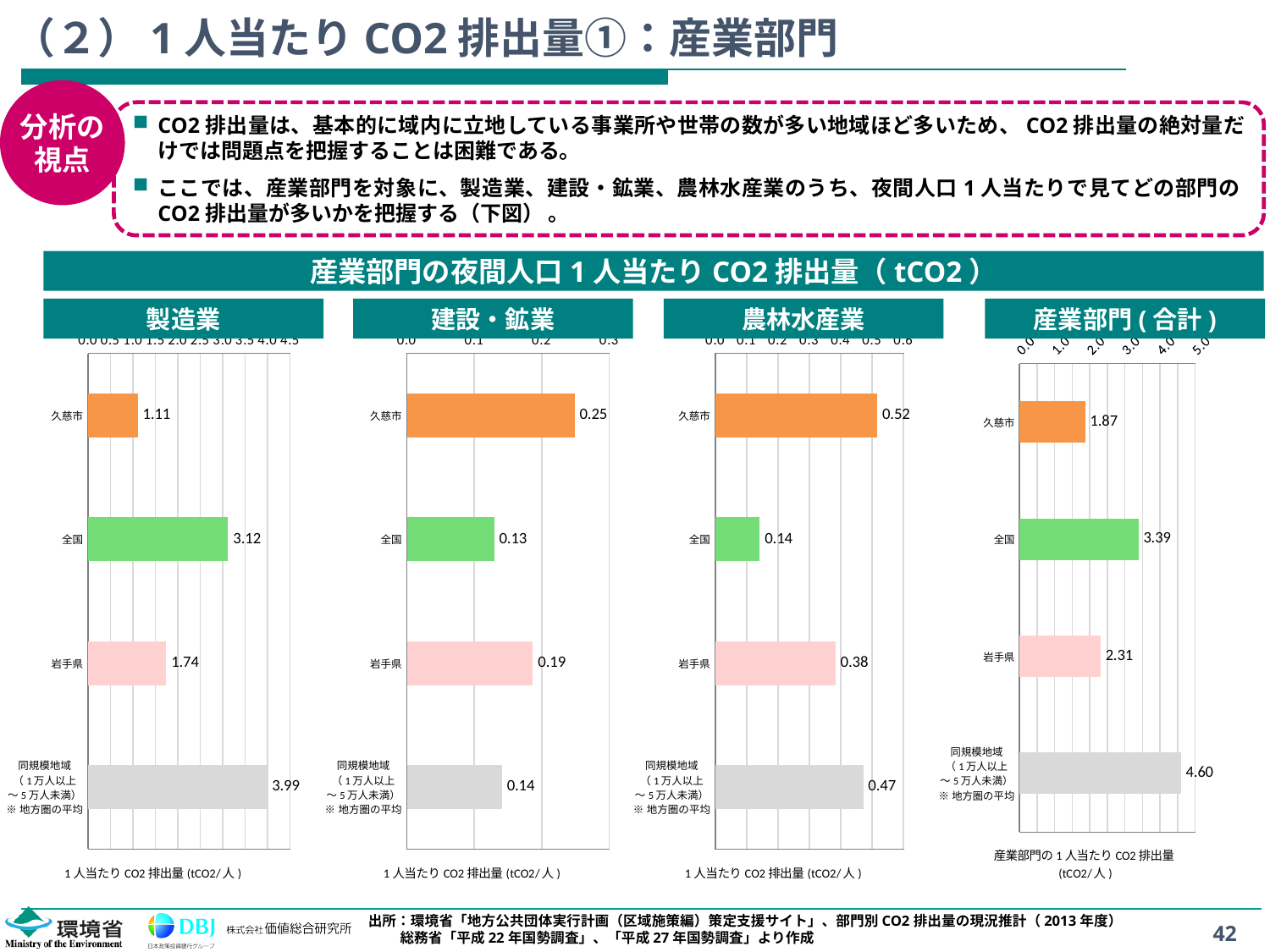
In the 産業部門(合計) chart, what is the value for 同規模地域? 4.60 In the 産業部門(合計) chart, what is the difference between the values for 全国 and 久慈市? 1.52 In the 農林水産業 chart, which is larger, the value for 岩手県 or the value for 同規模地域? 同規模地域 In the 農林水産業 chart, what is the value for 久慈市? 0.52 How many categories are shown in the 産業部門(合計) chart? 4 In the 製造業 chart, what is the value for 全国? 3.12 In the 産業部門(合計) chart, is the value for 全国 greater or less than 3.0? greater What kind of chart is the 製造業 chart? bar chart In the 製造業 chart, what is the difference between the values for 同規模地域 and 久慈市? 2.88 In the 製造業 chart, which category has the highest value? 同規模地域 In the 建設・鉱業 chart, which category has the lowest value? 全国 In the 建設・鉱業 chart, what is the value for 久慈市? 0.25